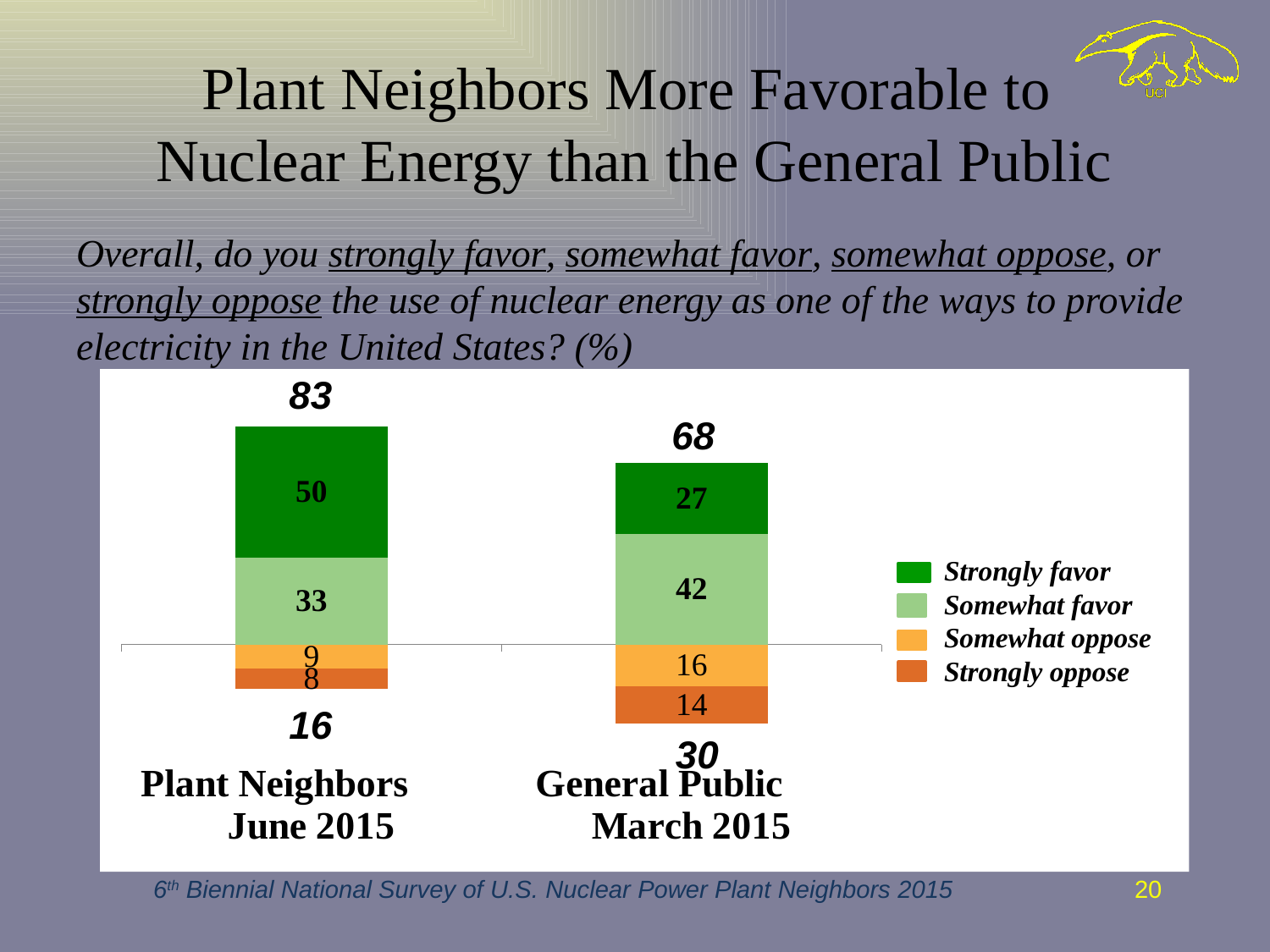
What is the combined oppose total shown below the General Public March 2015 bar? 30 What is the Strongly favor value for Plant Neighbors June 2015? 50 Which group has the larger Somewhat favor value, Plant Neighbors June 2015 or General Public March 2015? General Public March 2015 What is the difference between the Strongly favor values for Plant Neighbors June 2015 and General Public March 2015? 23 What is the Strongly oppose value for General Public March 2015? 14 What is the combined favor total shown above the Plant Neighbors June 2015 bar? 83 What is the Somewhat favor value for General Public March 2015? 42 How many groups (categories) are shown on the x axis? 2 What kind of chart is shown on the slide? Stacked bar chart What is the Somewhat oppose value for Plant Neighbors June 2015? 9 Which group has the higher Strongly oppose value? General Public March 2015 How many series does the legend list? 4